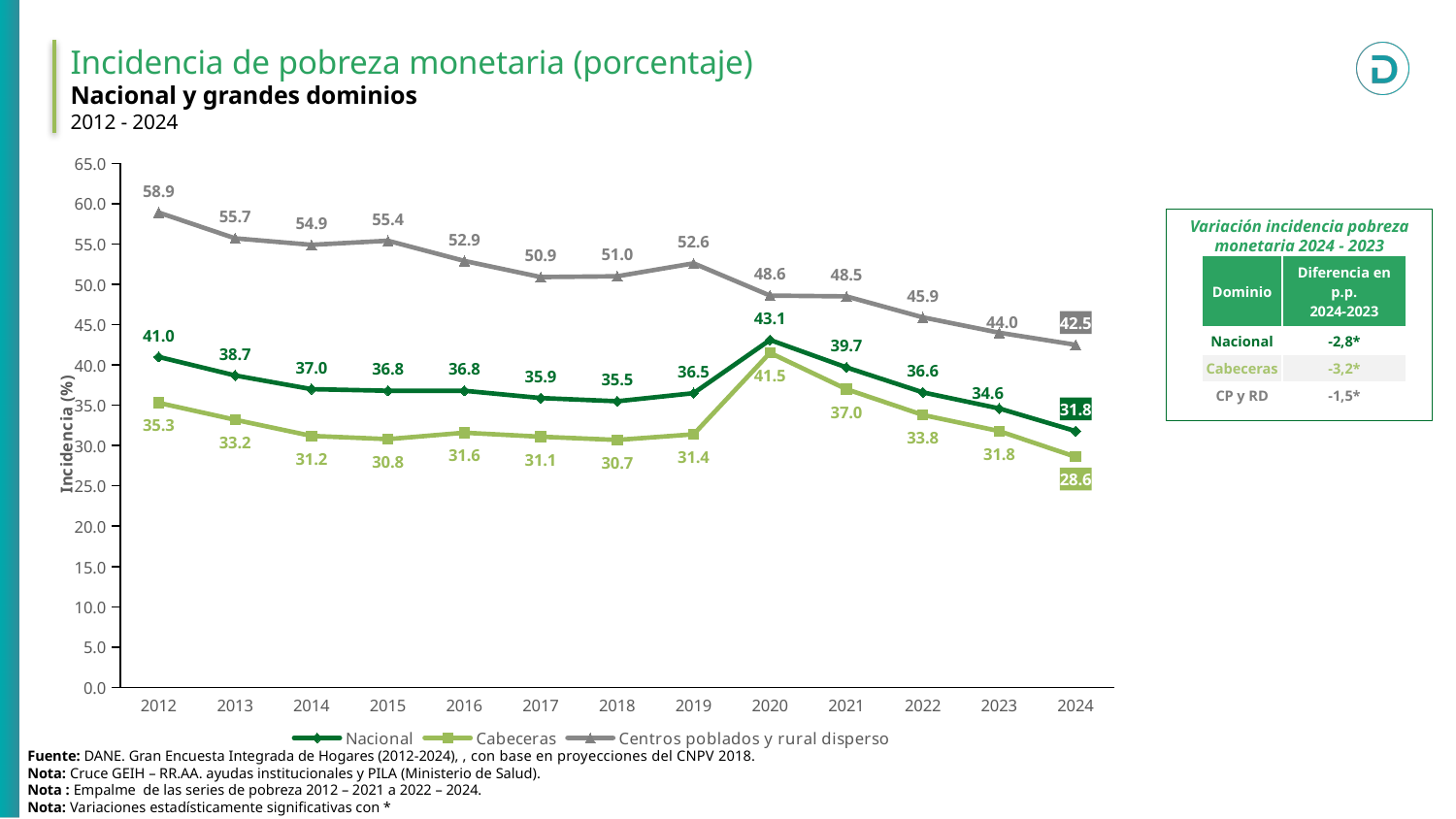
What is the difference between the Nacional value in 2012 and in 2024? 9.2 Is the value for Centros poblados y rural disperso in 2024 greater or less than 45.0? less What is the Cabeceras value in 2024? 28.6 What is the Nacional value in 2020? 43.1 How many years are shown on the x axis? 13 Does the Centros poblados y rural disperso series generally rise or fall from 2012 to 2024? Fall In 2018, which is larger: the Nacional value or the Cabeceras value? Nacional What kind of chart is shown on the slide? Line chart What is the value for Centros poblados y rural disperso in 2012? 58.9 How many series does the legend list? 3 In which year is the Cabeceras series at its lowest? 2024 In which year is the Nacional series at its highest? 2020